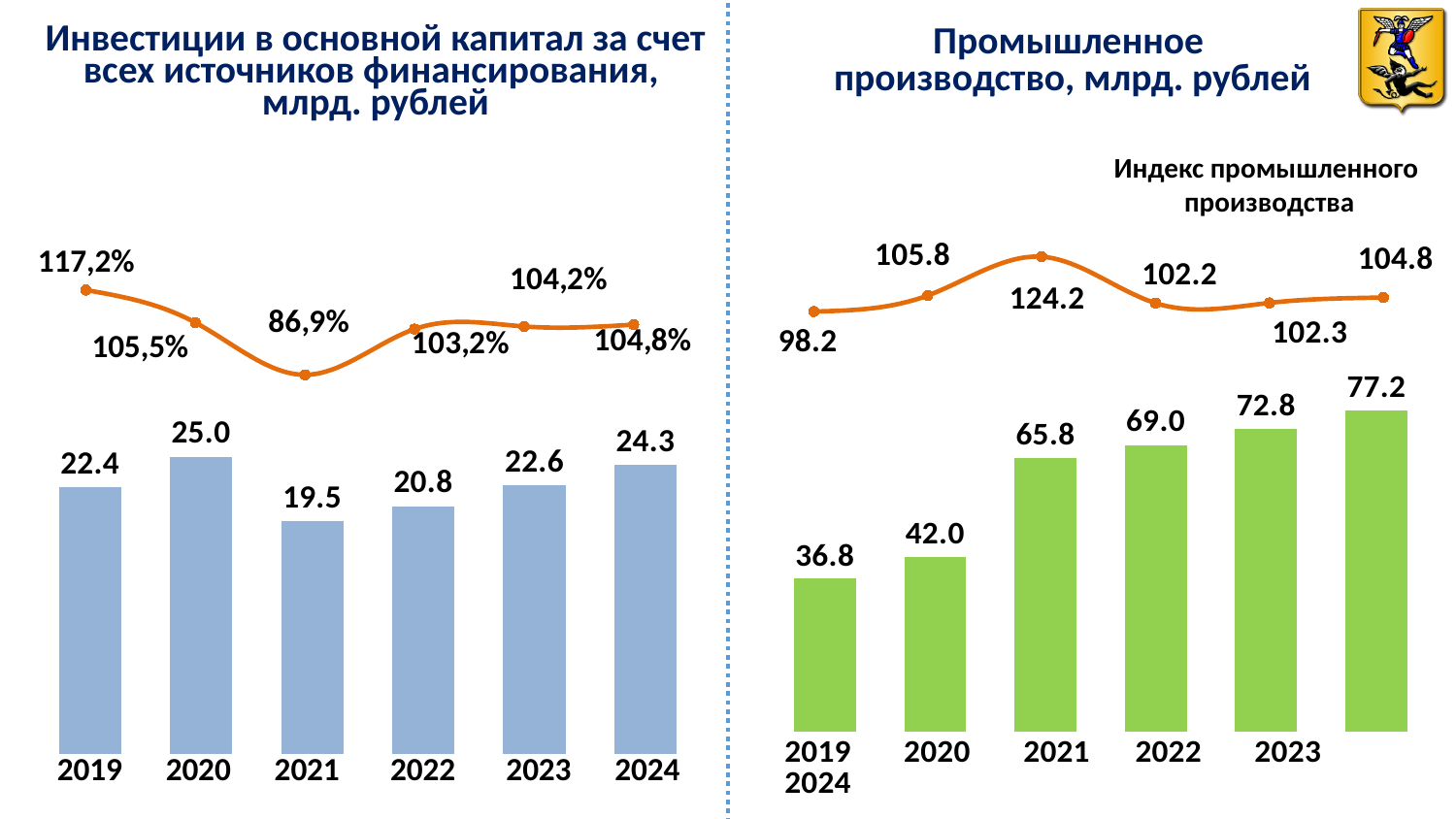
On the left chart (Инвестиции в основной капитал), how many years are shown on the x axis? 6 On the right chart (Промышленное производство), what is the highest value of the Индекс промышленного производства line? 124.2 On the left chart (Инвестиции в основной капитал), is the value for 2024 larger or smaller than the value for 2023? larger On the left chart (Инвестиции в основной капитал), what percentage is shown on the line for 2021? 86,9% On the left chart (Инвестиции в основной капитал), what is the difference between the 2020 and 2021 values? 5.5 What type of chart is used for the values on the right chart (Промышленное производство)? bar chart with a line On the right chart (Промышленное производство), what is the value for 2021? 65.8 On the left chart (Инвестиции в основной капитал), which year has the lowest bar? 2021 On the right chart (Промышленное производство), what is the difference between the 2020 and 2019 values? 5.2 On the left chart (Инвестиции в основной капитал), what is the value for 2020? 25.0 On the right chart (Промышленное производство), do the bar values rise or fall from left to right? rise On the right chart (Промышленное производство), what is the value of the rightmost bar? 77.2